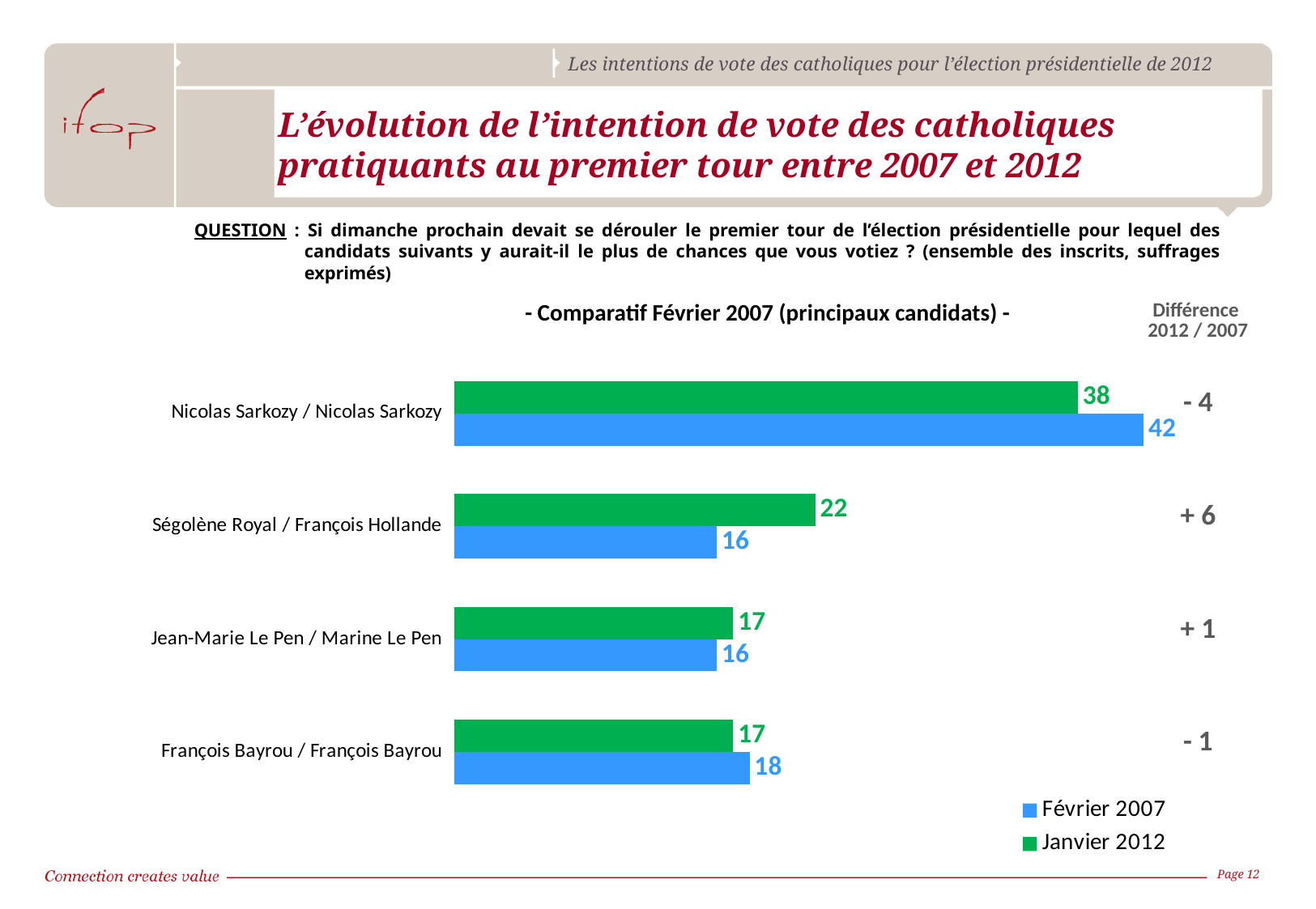
Which category has the highest Janvier 2012 value? Nicolas Sarkozy / Nicolas Sarkozy What is the 'Différence 2012 / 2007' shown for Jean-Marie Le Pen / Marine Le Pen? + 1 What kind of chart is shown on the slide? Bar chart What is the Février 2007 value for François Bayrou / François Bayrou? 18 Which category has the lowest Février 2007 value? Ségolène Royal / François Hollande and Jean-Marie Le Pen / Marine Le Pen (both 16) What is the difference between the Février 2007 and Janvier 2012 values for Ségolène Royal / François Hollande? 6 What is the Janvier 2012 value for Nicolas Sarkozy / Nicolas Sarkozy? 38 Which is larger for Nicolas Sarkozy / Nicolas Sarkozy: the Février 2007 value or the Janvier 2012 value? Février 2007 What is the Février 2007 value for Ségolène Royal / François Hollande? 16 How many candidate categories are shown in the chart? 4 Which colour represents the Janvier 2012 series? Green How many series does the legend list? 2